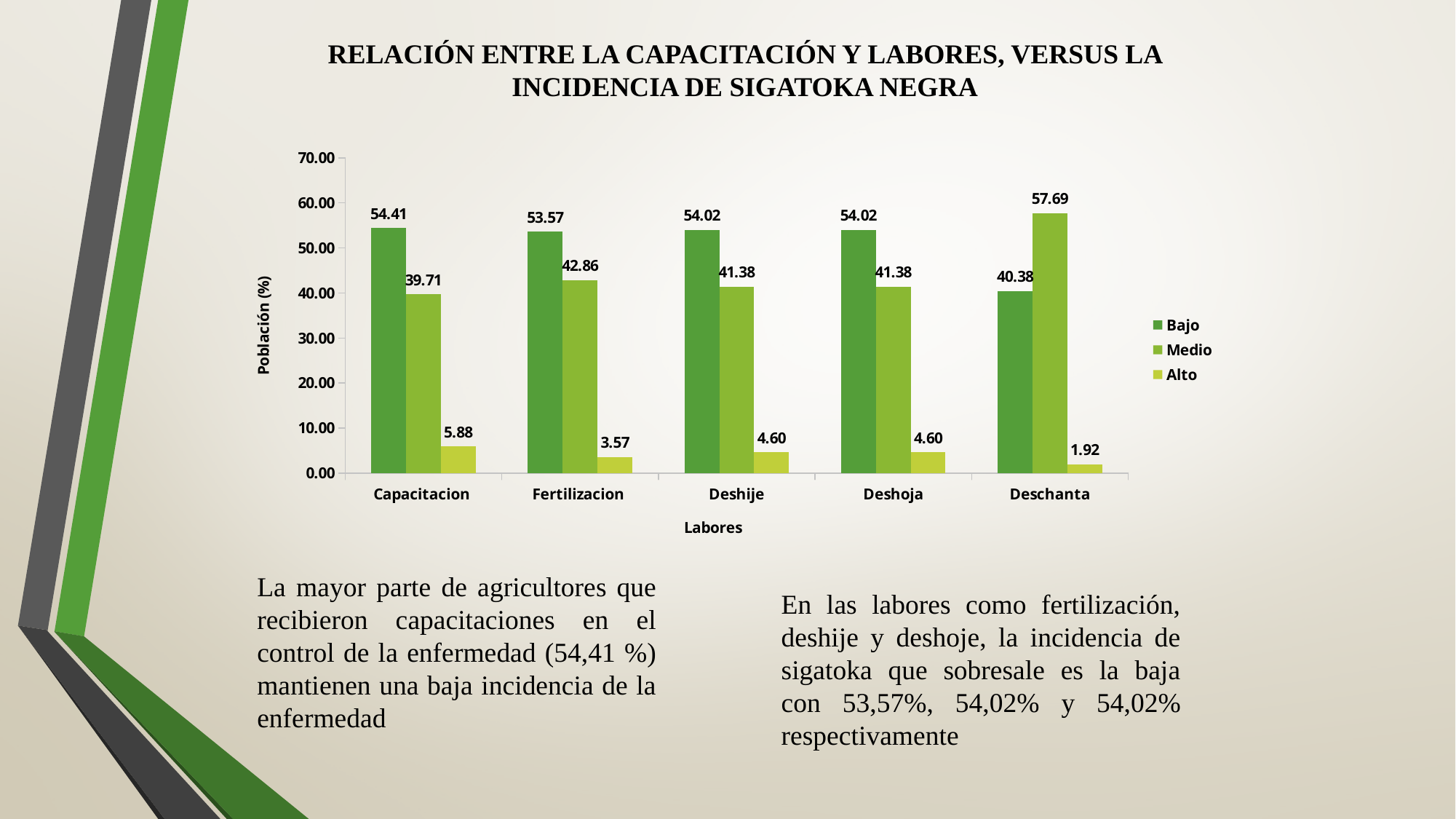
What is the Alto value for Fertilizacion? 3.57 What is the label of the y axis? Población (%) For Deschanta, which is larger, the Bajo value or the Medio value? Medio Is the Medio value for Fertilizacion greater or less than 40.00? greater Which category has the lowest Alto value? Deschanta How many categories are shown on the x axis? 5 What kind of chart is shown on the slide? Bar chart What is the Bajo value for Capacitacion? 54.41 How many series does the legend list? 3 What is the difference between the Bajo and Medio values for Capacitacion? 14.70 What is the Medio value for Deschanta? 57.69 Which category has the highest Medio value? Deschanta